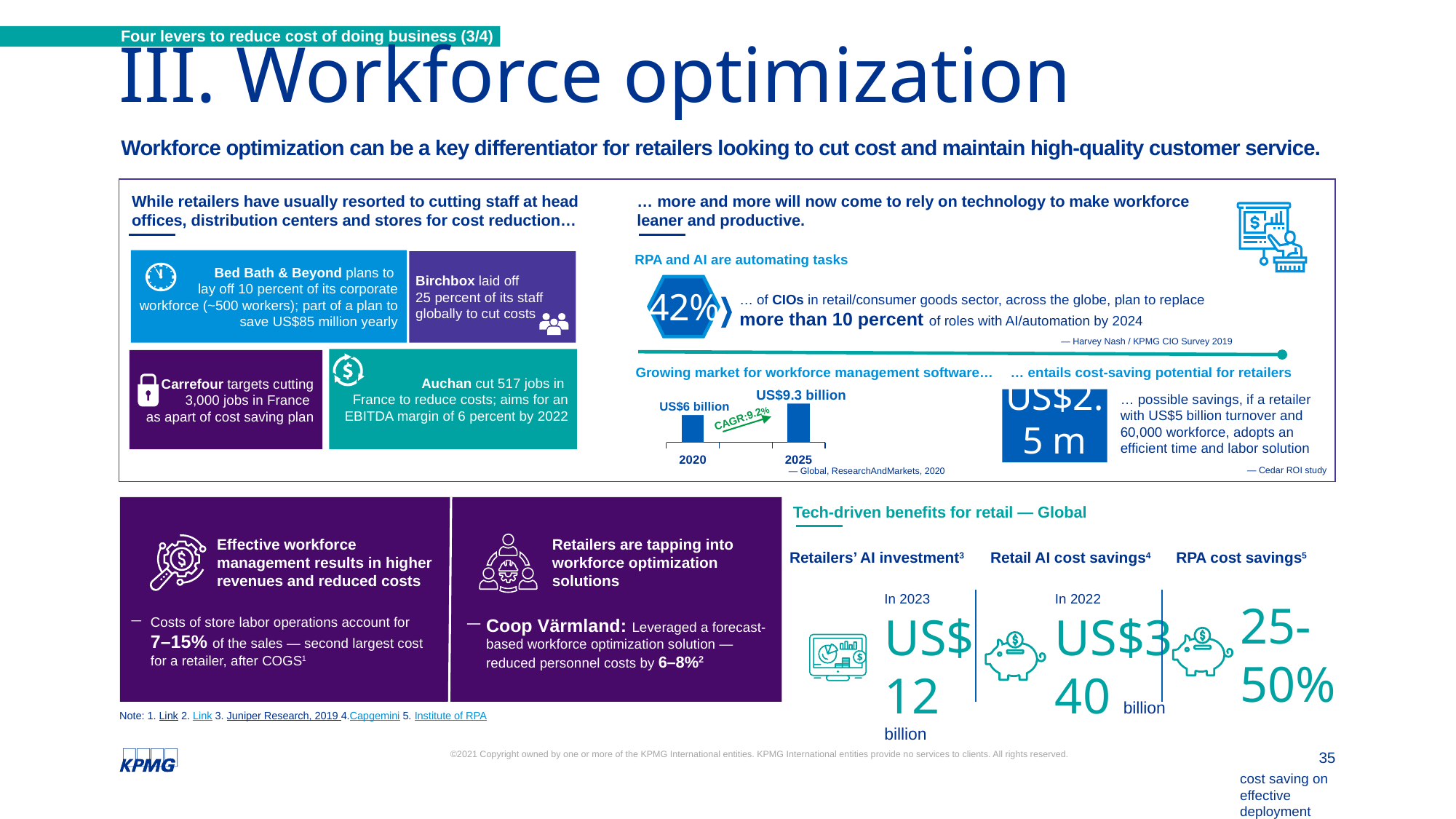
What CAGR is labelled on the 'Growing market for workforce management software' chart? 9.2% In the 'Growing market for workforce management software' chart, what is the difference between the 2025 and 2020 values? US$3.3 billion How many years are shown in the 'Growing market for workforce management software' chart? 2 In the 'Growing market for workforce management software' chart, which year has the higher value? 2025 In the 'Growing market for workforce management software' chart, what is the value for 2025? US$9.3 billion In the 'Growing market for workforce management software' chart, do the values rise or fall from 2020 to 2025? rise What kind of chart is the 'Growing market for workforce management software' chart? bar chart What source is cited beneath the 'Growing market for workforce management software' chart? Global, ResearchAndMarkets, 2020 In the 'Growing market for workforce management software' chart, which year has the lower value? 2020 In the 'Growing market for workforce management software' chart, what is the value for 2020? US$6 billion In the 'Growing market for workforce management software' chart, is the value for 2025 larger or smaller than the value for 2020? larger